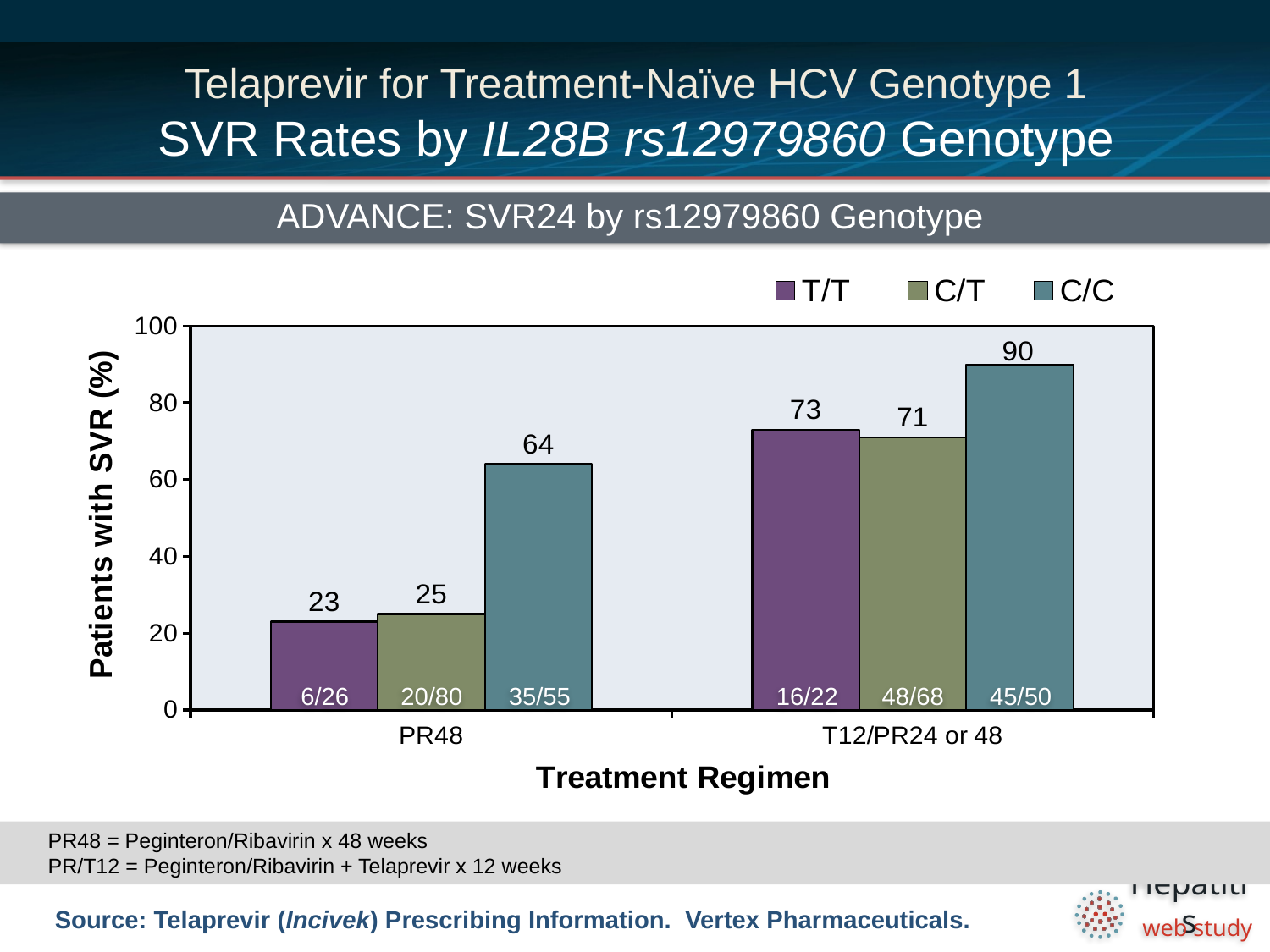
What is the SVR rate for the T/T genotype in the T12/PR24 or 48 regimen? 73 What is the SVR rate for the C/T genotype in the PR48 regimen? 25 Which genotype has the highest SVR rate in the T12/PR24 or 48 regimen? C/C Which genotype has the lowest SVR rate in the PR48 regimen? T/T How many treatment regimens are shown on the x axis? 2 What kind of chart is shown on the slide? Bar chart How many genotype series does the legend list? 3 Which is larger: the SVR rate for T/T in the T12/PR24 or 48 regimen or the SVR rate for C/T in the same regimen? T/T Is the SVR rate for C/C in the T12/PR24 or 48 regimen greater or less than 80? greater What is the SVR rate for the C/C genotype in the PR48 regimen? 64 What is the label of the y axis? Patients with SVR (%) What is the difference in SVR rate for the C/C genotype between the T12/PR24 or 48 regimen and the PR48 regimen? 26